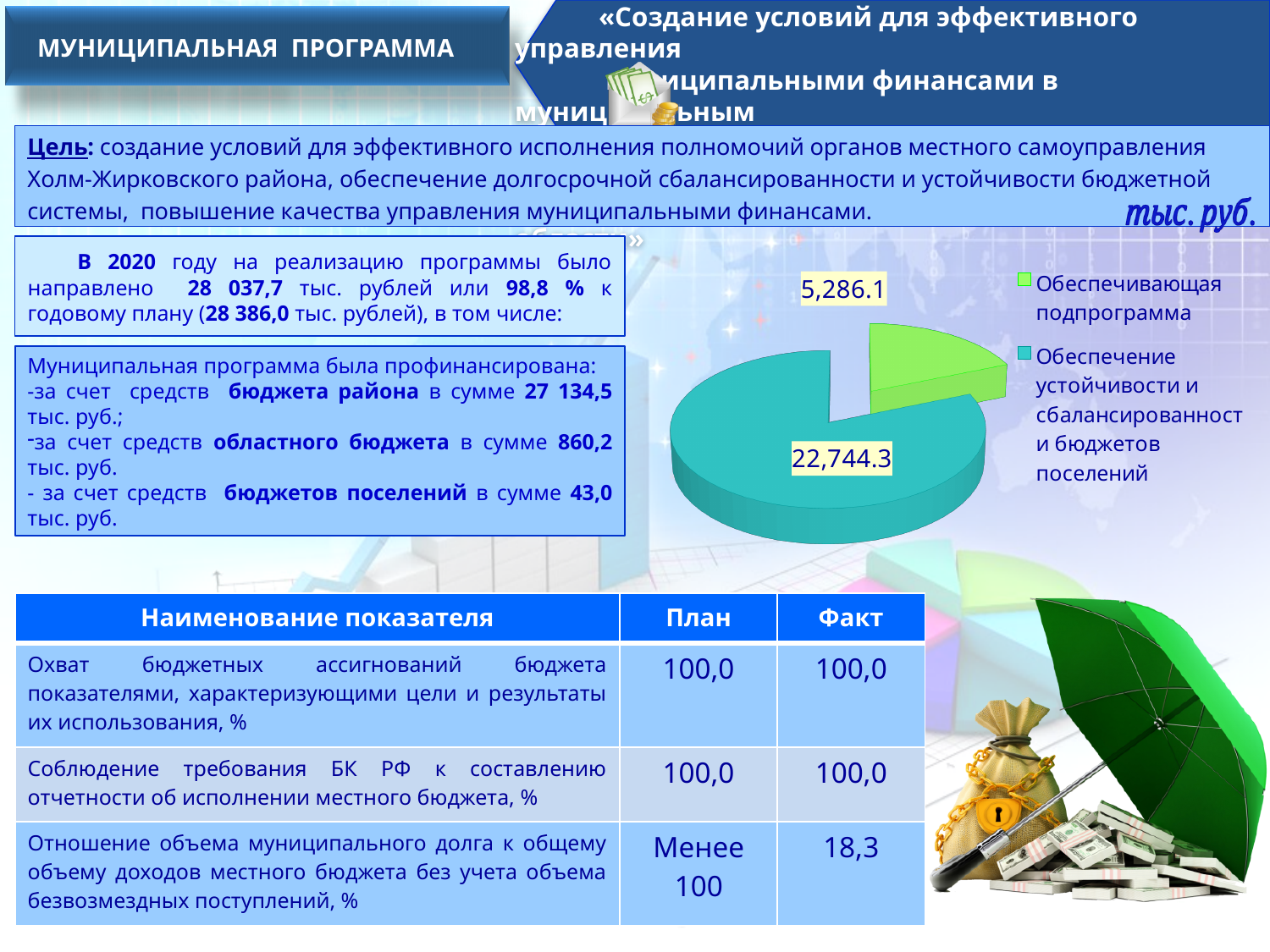
What colour is the 'Обеспечивающая подпрограмма' slice in the pie chart? Light green Which slice of the pie chart is the smallest? Обеспечивающая подпрограмма What is the difference between the two slices of the pie chart (22,744.3 and 5,286.1)? 17,458.2 How many slices does the pie chart have? 2 How many entries does the pie chart legend list? 2 Which slice of the pie chart is the largest? Обеспечение устойчивости и сбалансированности бюджетов поселений What is the total of the two values shown in the pie chart? 28,030.4 Which is larger in the pie chart: 'Обеспечивающая подпрограмма' or 'Обеспечение устойчивости и сбалансированности бюджетов поселений'? Обеспечение устойчивости и сбалансированности бюджетов поселений What is the value for the 'Обеспечение устойчивости и сбалансированности бюджетов поселений' slice in the pie chart? 22,744.3 What type of chart is shown on the slide? Pie chart What unit is indicated for the values in the pie chart? тыс. руб. What is the value for the 'Обеспечивающая подпрограмма' slice in the pie chart? 5,286.1